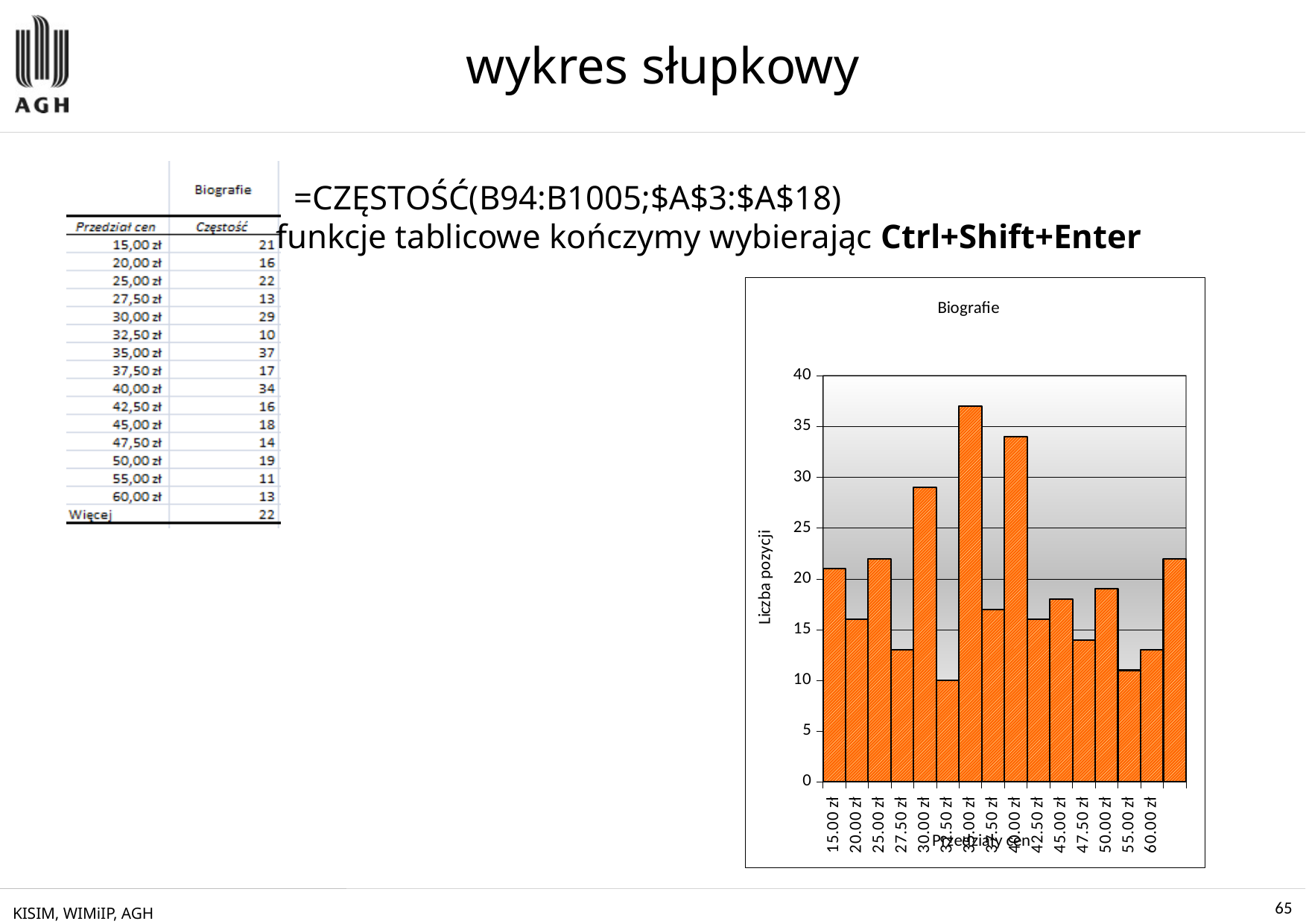
What is the value for the 35.00 zł interval? 37 What type of chart is shown on the slide? bar chart What is the value for the 32.50 zł interval? 10 Is the value for 35.00 zł greater or less than 35? greater Which price interval has the highest bar in the chart? 35.00 zł Which price interval has the lowest bar in the chart? 32.50 zł How many bars are plotted in the chart? 16 What is the value for the 30.00 zł interval? 29 What is the title of the chart? Biografie What is the label of the vertical axis of the chart? Liczba pozycji Which has a larger value, 30.00 zł or 40.00 zł? 40.00 zł What is the difference between the values for 35.00 zł and 40.00 zł? 3